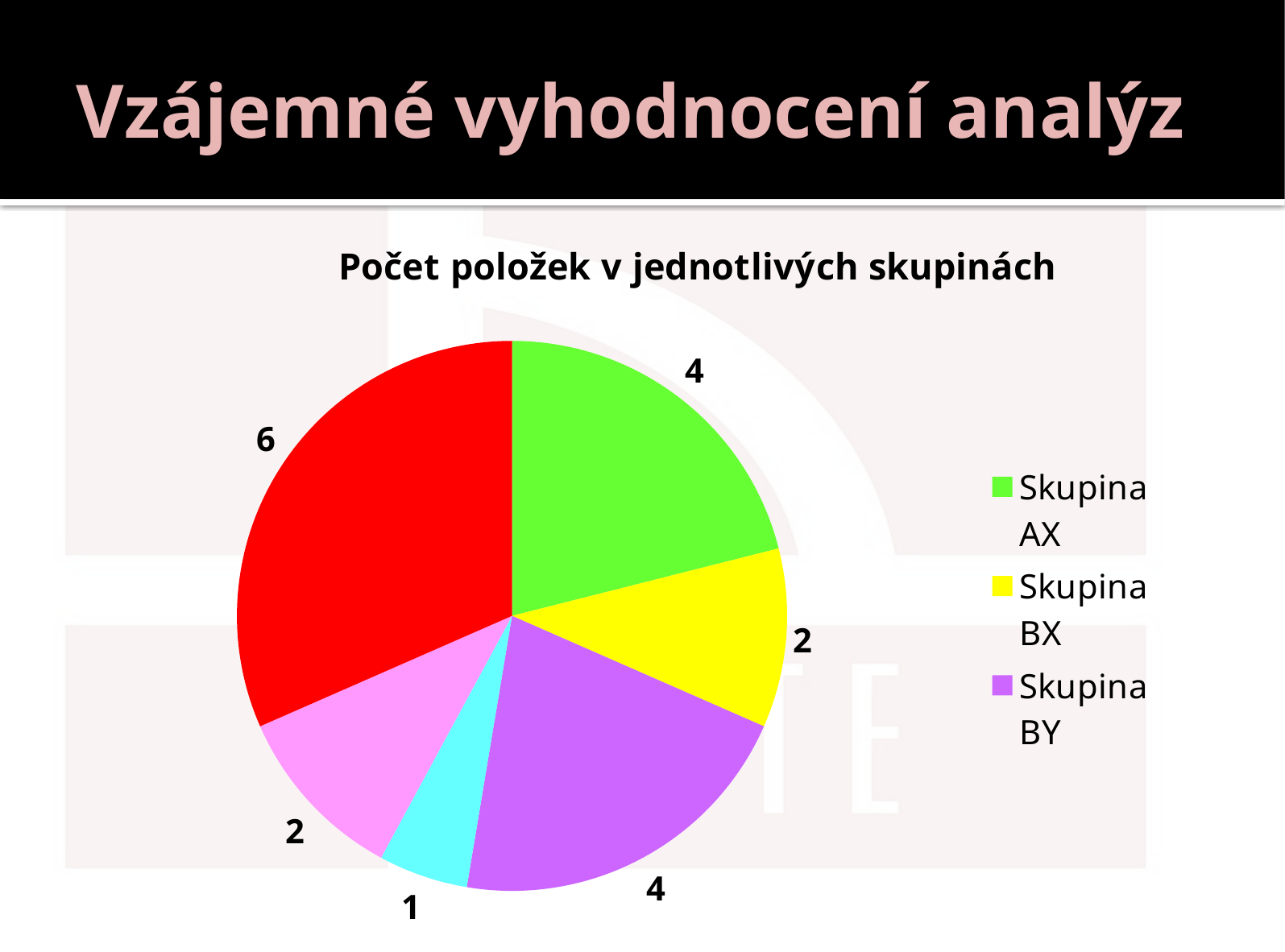
What is the value for Skupina AX? 4 What is the value of the largest slice in the pie chart? 6 What colour is the slice for Skupina BY? purple What is the difference between the values for Skupina AX and Skupina BX? 2 What is the value of the smallest slice in the pie chart? 1 How many slices does the pie chart have? 6 What kind of chart is shown on the slide? pie chart What is the value for Skupina BX? 2 What is the title of the chart? Počet položek v jednotlivých skupinách What is the value for Skupina BY? 4 What is the sum of all the slice values shown on the pie chart? 19 Which is larger, Skupina BX or Skupina BY? Skupina BY